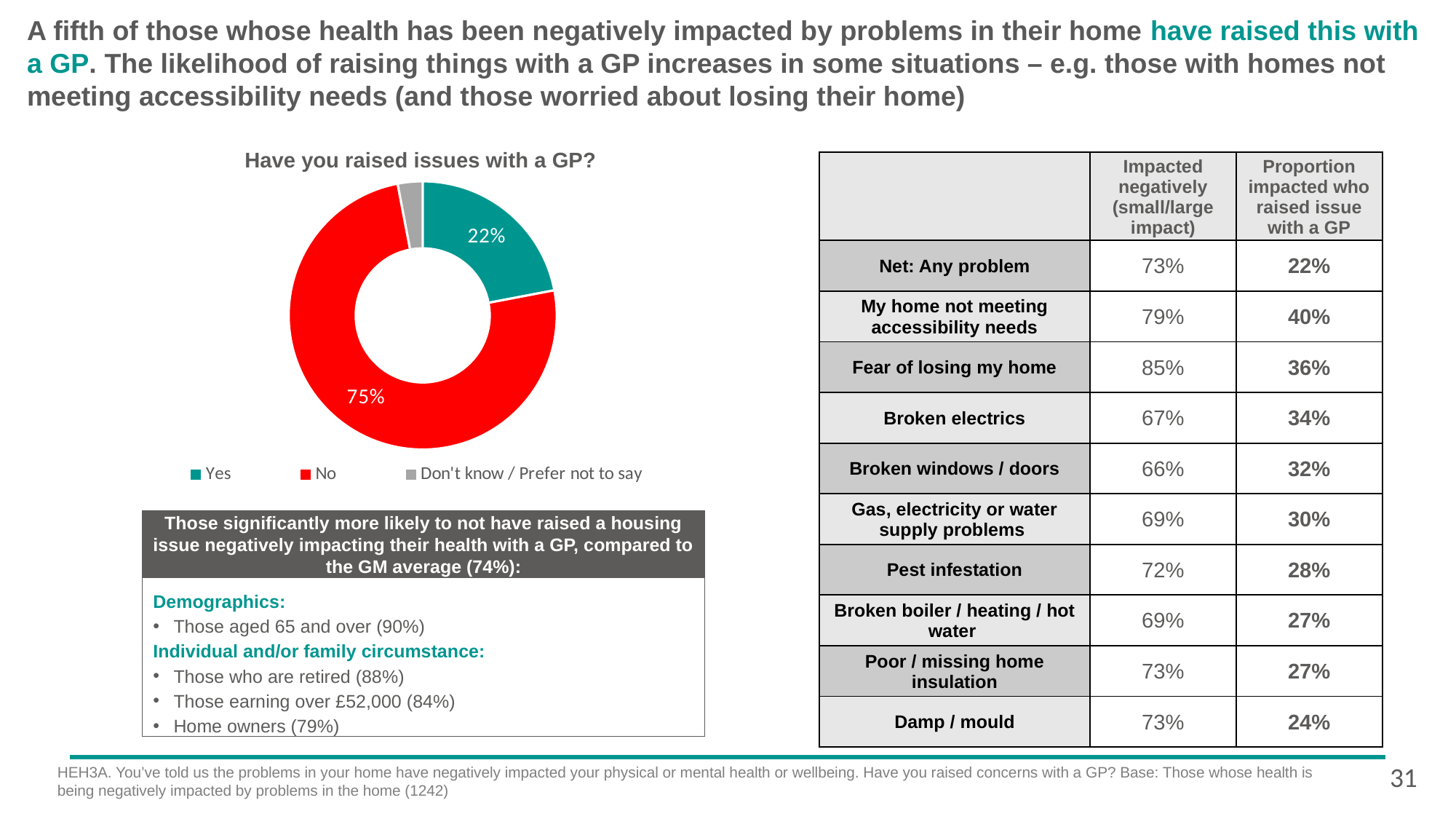
Is the share for "Yes" greater or less than 50%? less What percentage of respondents answered "Yes" in the chart? 22% What is the title of the chart? Have you raised issues with a GP? What is the difference in percentage points between the "No" and "Yes" slices? 53 percentage points What percentage of respondents answered "No" in the chart? 75% What colour is the "No" slice in the chart? Red What type of chart is shown on the slide? Pie chart (donut) How many categories does the chart's legend list? 3 Is the share for "No" greater or less than 50%? greater Which response has the smallest share of the chart? Don't know / Prefer not to say Which response has the largest share of the chart? No Which is larger in the chart, the "Yes" slice or the "No" slice? No